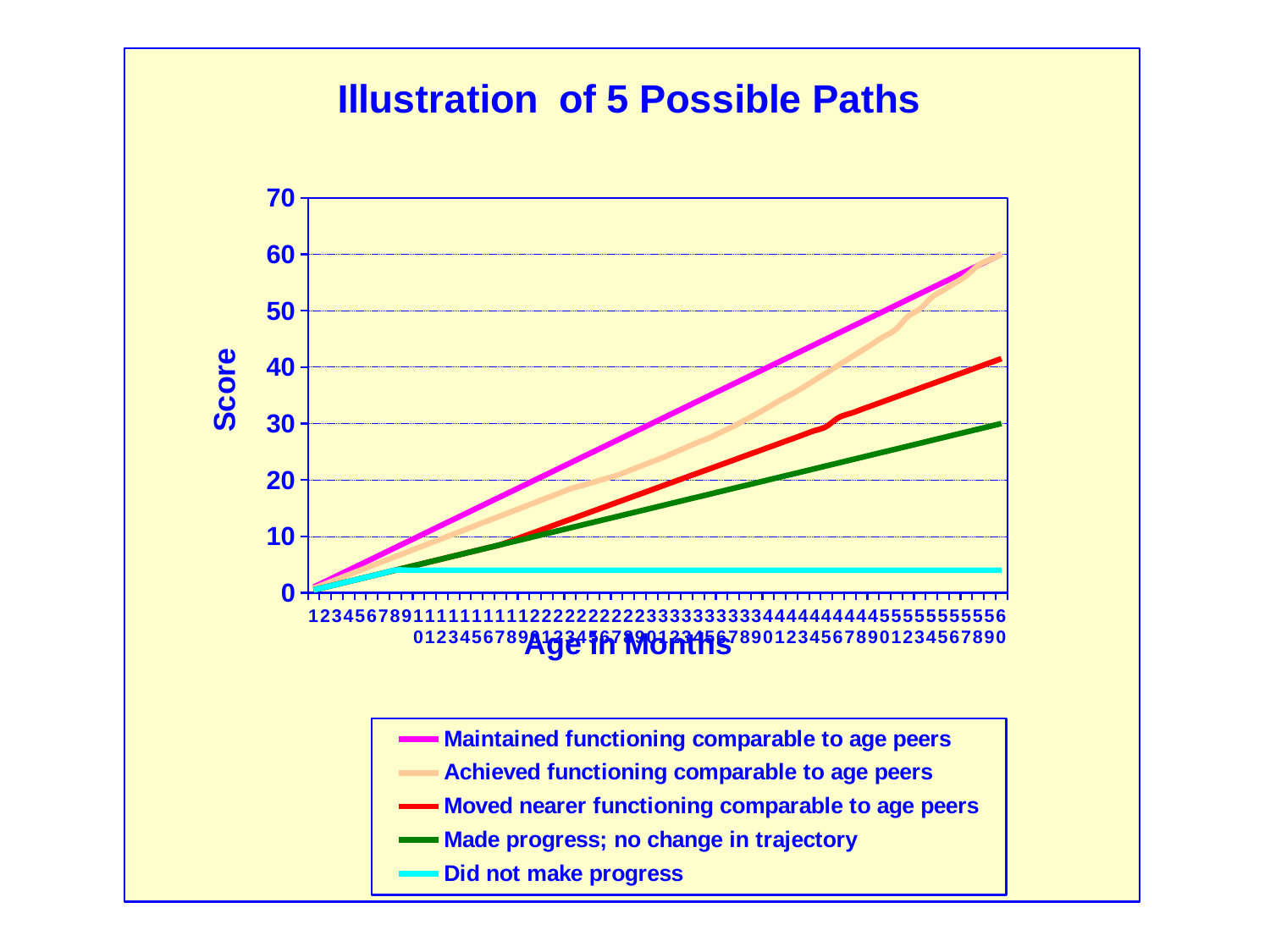
Is the score for 'Did not make progress' at the right end of the chart greater or less than 10? less Is the score for 'Made progress; no change in trajectory' at the right end of the chart greater or less than 20? greater What is the label on the vertical axis? Score How many series does the legend list? 5 What kind of chart is shown on the slide? line chart Does the 'Maintained functioning comparable to age peers' line rise or fall as age in months increases? rise Which series has the lowest score at the right end of the chart? Did not make progress Is the score for 'Moved nearer functioning comparable to age peers' at the right end of the chart greater or less than 30? greater What is the title of the chart? Illustration of 5 Possible Paths At the right end of the chart, which is higher: 'Moved nearer functioning comparable to age peers' or 'Made progress; no change in trajectory'? Moved nearer functioning comparable to age peers Does the 'Made progress; no change in trajectory' line rise or fall as age in months increases? rise Does the 'Did not make progress' line rise, fall, or stay flat as age in months increases? stay flat